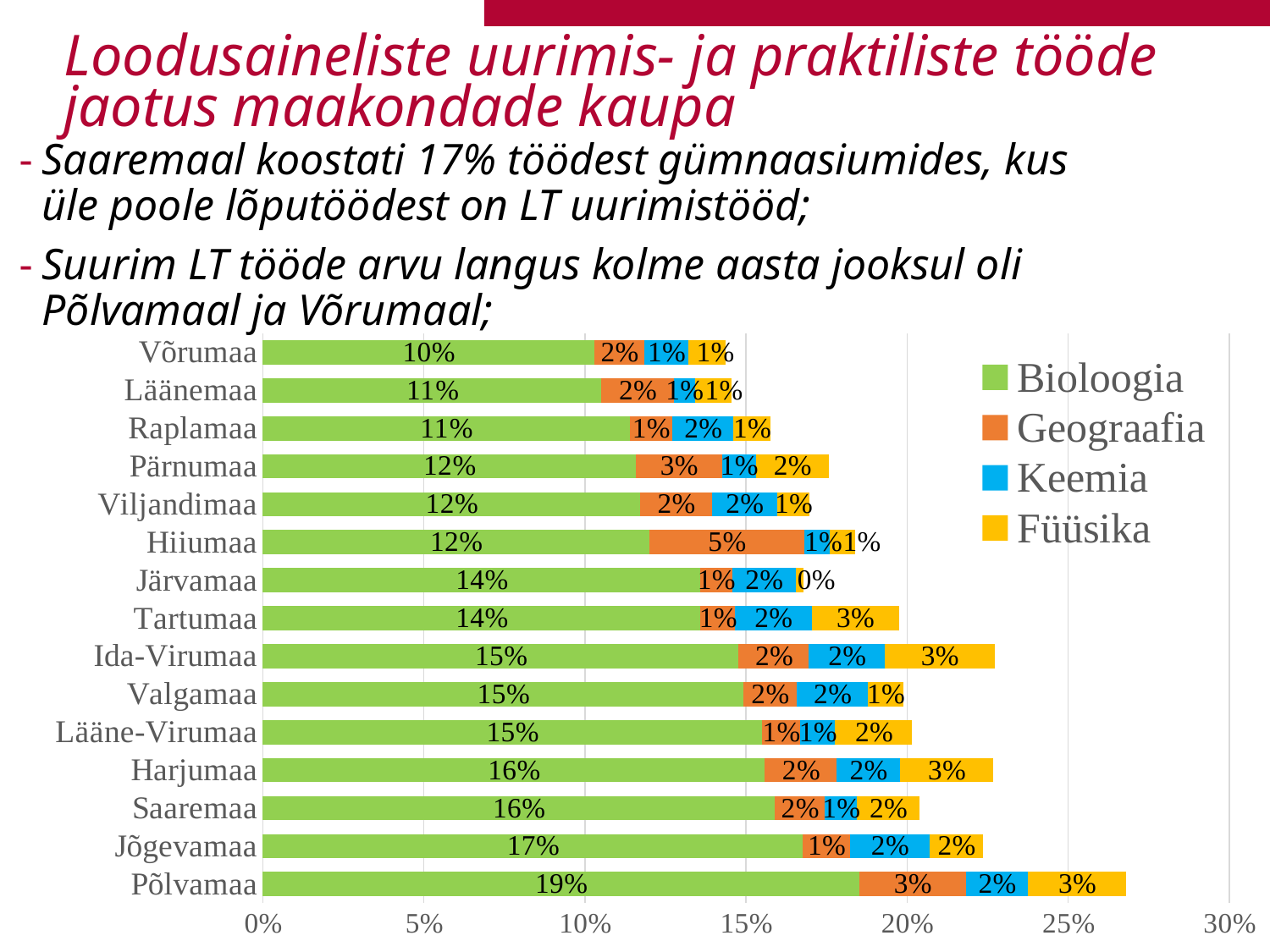
Which county has the lowest Bioloogia value? Võrumaa What is the Bioloogia value for Põlvamaa? 19% Which county has the highest Bioloogia value? Põlvamaa What is the difference between the Bioloogia values for Põlvamaa and Võrumaa? 9 percentage points Is the total bar length for Põlvamaa greater or less than 25%? greater What is the Geograafia value for Hiiumaa? 5% What kind of chart is shown on the slide? Stacked bar chart What is the Füüsika value for Järvamaa? 0% Which is larger, the Geograafia value for Hiiumaa or the Geograafia value for Pärnumaa? Hiiumaa How many counties (categories) are plotted in the chart? 15 Which legend entry is shown in green? Bioloogia How many series does the chart legend list? 4